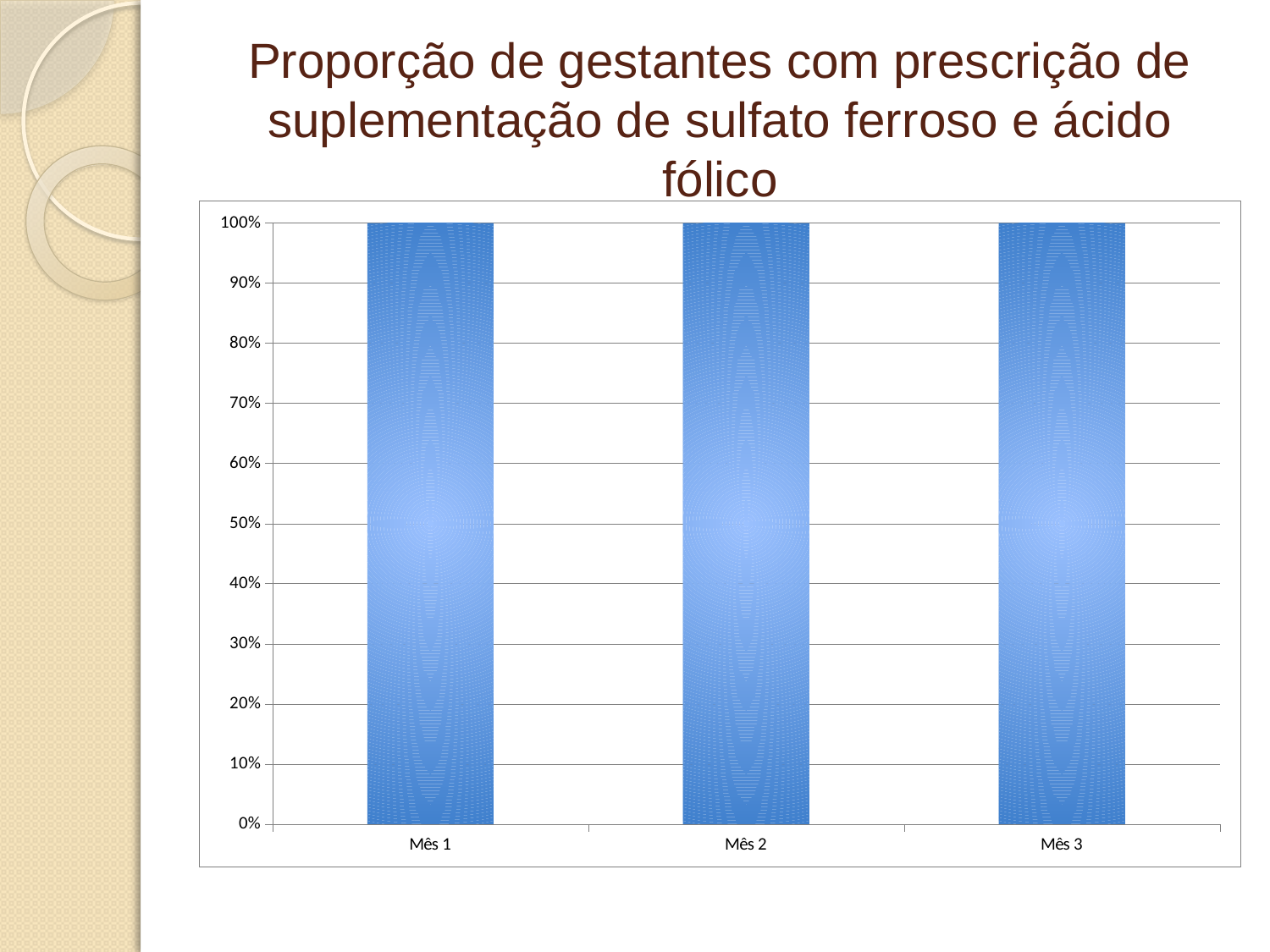
What is the highest value shown on the y axis? 100% How many categories are shown on the x axis? 3 What is the value for Mês 3? 100% What is the difference between the values for Mês 1 and Mês 3? 0% What is the value for Mês 1? 100% What kind of chart is shown on the slide? Bar chart Is the value for Mês 2 greater or less than 90%? greater What is the title of the chart? Proporção de gestantes com prescrição de suplementação de sulfato ferroso e ácido fólico Is the value for Mês 3 greater or less than 50%? greater